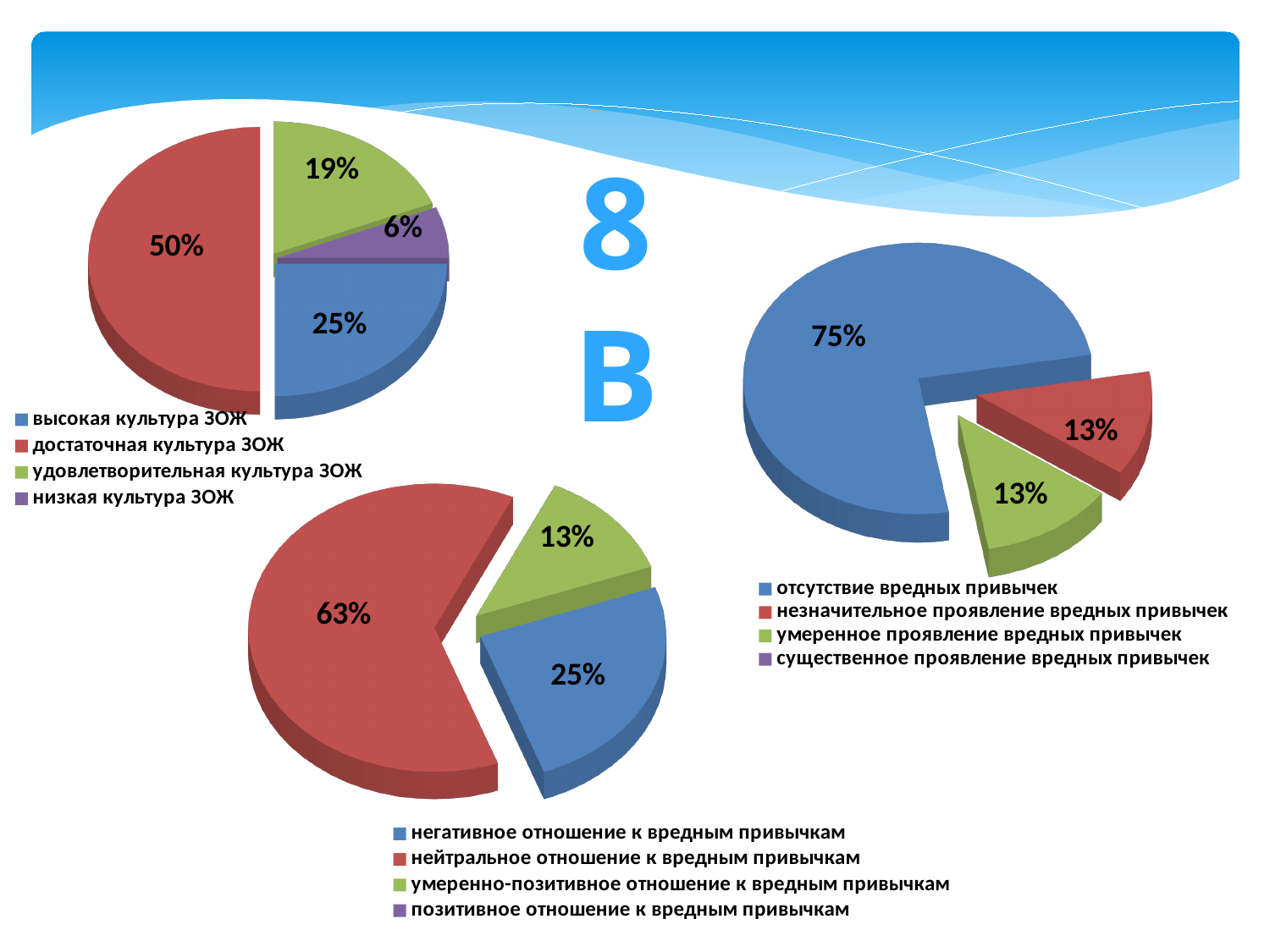
In the bottom pie chart, what is the difference between the shares for 'нейтральное отношение к вредным привычкам' and 'негативное отношение к вредным привычкам'? 38% In the top-left pie chart, what share is labelled for 'низкая культура ЗОЖ'? 6% In the top-left pie chart, which category has the smallest slice? низкая культура ЗОЖ In the pie chart on the right, what share is labelled for 'отсутствие вредных привычек'? 75% In the pie chart on the right, what share is labelled for 'незначительное проявление вредных привычек'? 13% In the top-left pie chart, what share is labelled for 'достаточная культура ЗОЖ'? 50% In the bottom pie chart, what share is labelled for 'нейтральное отношение к вредным привычкам'? 63% In the top-left pie chart, which category has the largest slice? достаточная культура ЗОЖ What type of chart is the bottom chart on the slide? pie chart In the bottom pie chart, which is larger: 'негативное отношение к вредным привычкам' or 'умеренно-позитивное отношение к вредным привычкам'? негативное отношение к вредным привычкам In the pie chart on the right, how many entries does the legend list? 4 In the top-left pie chart, what is the difference between the shares for 'достаточная культура ЗОЖ' and 'высокая культура ЗОЖ'? 25%